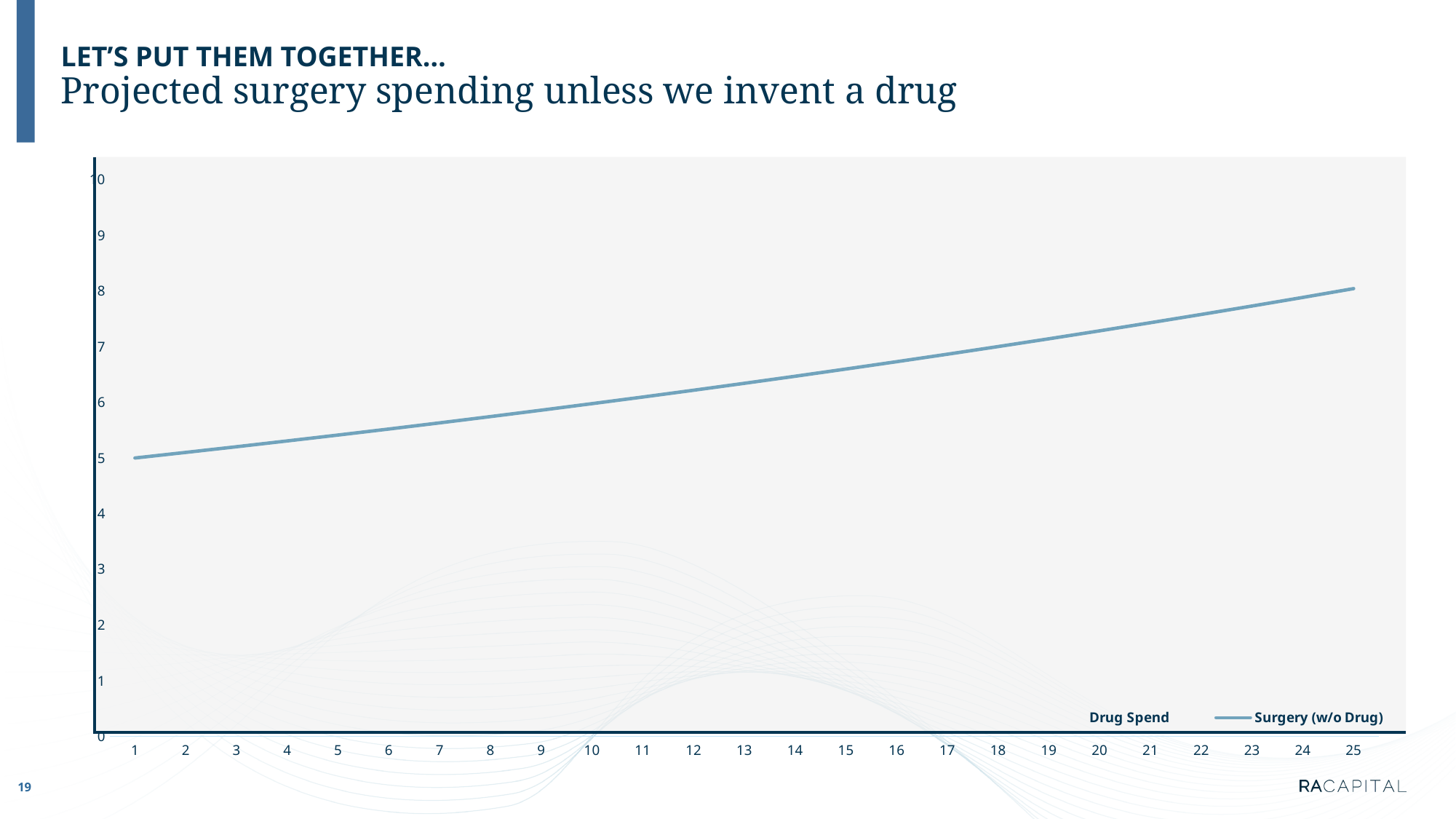
What are the two series named in the legend? Drug Spend and Surgery (w/o Drug) At which x value is the Surgery (w/o Drug) line lowest? 1 Which is larger for the Surgery (w/o Drug) line: the value at x = 25 or the value at x = 1? x = 25 What kind of chart is shown on the slide? Line chart Is the value of the Surgery (w/o Drug) line at x = 5 greater or less than 6? less What is the value of the Surgery (w/o Drug) line at x = 1? 5 How many points are labelled along the x axis? 25 Does the Surgery (w/o Drug) line rise or fall as the x axis increases from 1 to 25? Rises At which x value is the Surgery (w/o Drug) line highest? 25 How many series does the legend list? 2 Is the value of the Surgery (w/o Drug) line at x = 13 greater or less than 6? greater Is the value of the Surgery (w/o Drug) line at x = 25 greater or less than 7? greater